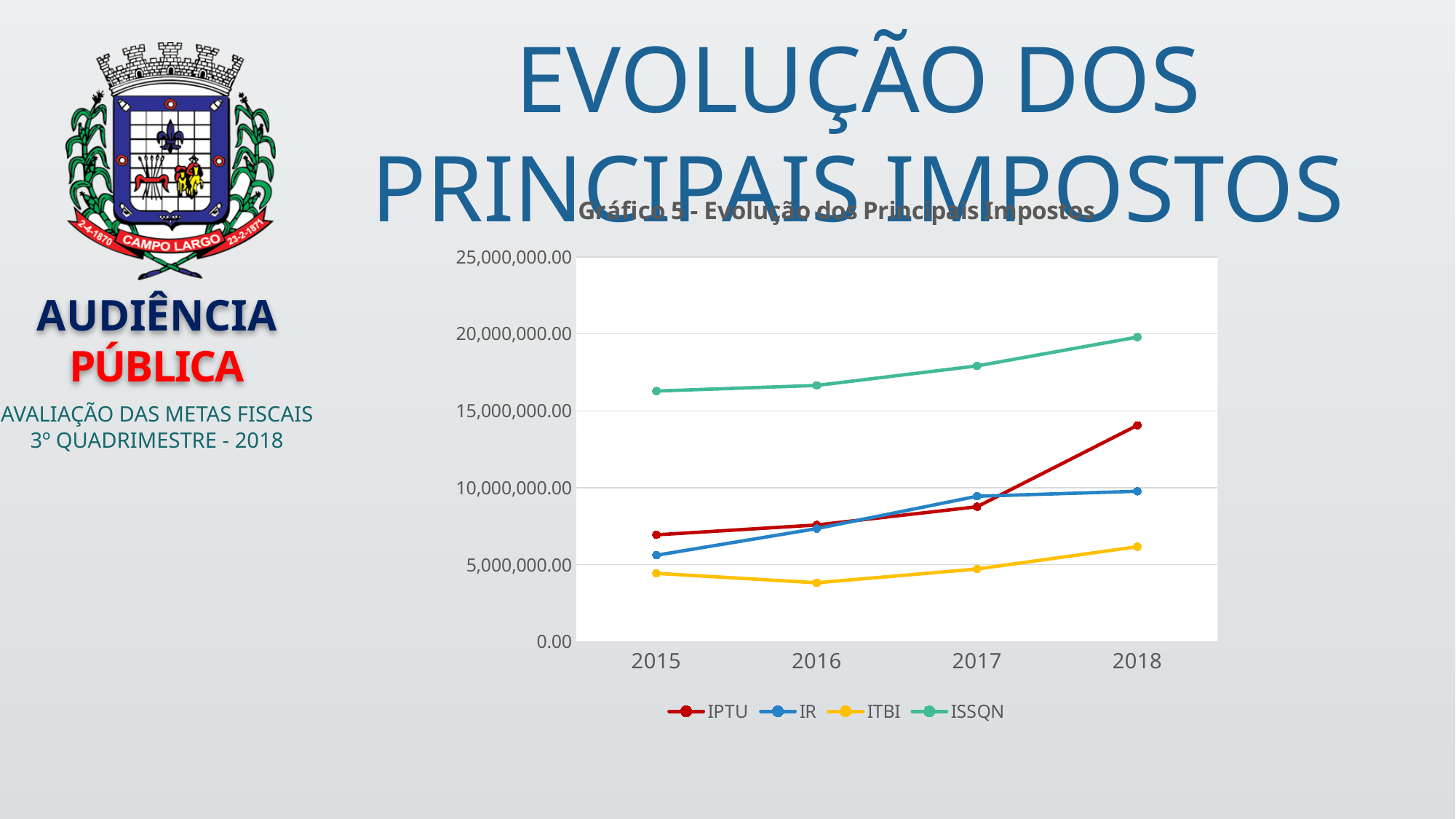
Is the value for IPTU in 2018 greater or less than 15,000,000.00? less Does the ISSQN series rise or fall from 2015 to 2018? rise Is the value for ISSQN in 2015 greater or less than 15,000,000.00? greater What kind of chart is shown on the slide? line chart Which is larger in 2018, IPTU or IR? IPTU What is the title of the chart? Gráfico 5 - Evolução dos Principais Impostos Which series has the lowest value in 2018? ITBI Is the value for ITBI in 2016 greater or less than 5,000,000.00? less How many series does the legend list? 4 Which series has the highest value in 2018? ISSQN How many years are plotted along the x axis? 4 In which year is the ITBI series at its lowest? 2016